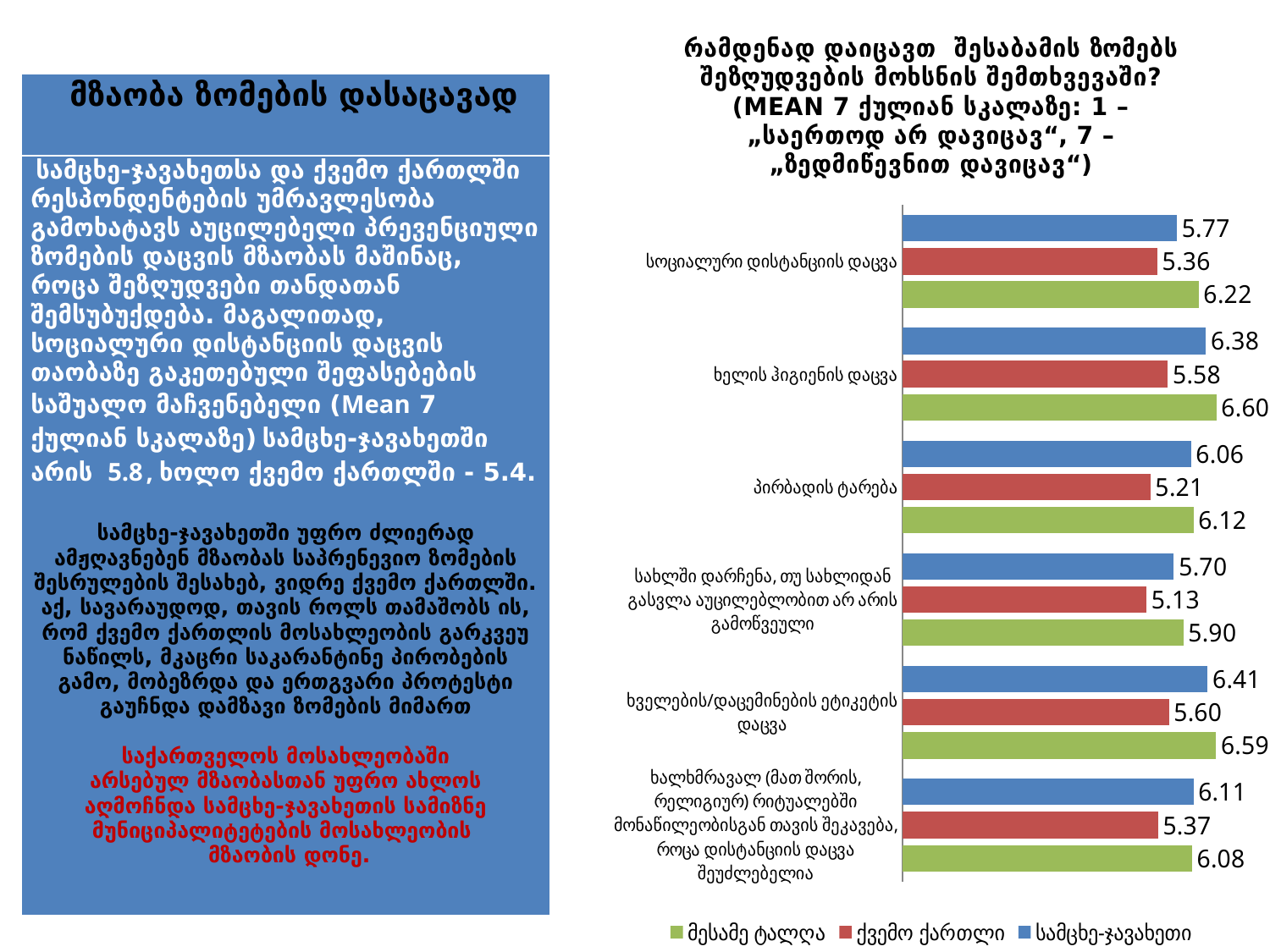
What type of chart is shown on the slide? bar chart What is the value for ქვემო ქართლი in the category პირბადის ტარება? 5.21 How many series does the chart legend list? 3 What is the difference between the მესამე ტალღა and ქვემო ქართლი values in the category ხელის ჰიგიენის დაცვა? 1.02 What is the difference between the სამცხე-ჯავახეთი and ქვემო ქართლი values in the category სოციალური დისტანციის დაცვა? 0.41 Which category has the lowest value for სამცხე-ჯავახეთი? სახლში დარჩენა, თუ სახლიდან გასვლა აუცილებლობით არ არის გამოწვეული What is the value for სამცხე-ჯავახეთი in the category სოციალური დისტანციის დაცვა? 5.77 Which category has the highest value for ქვემო ქართლი? ხველების/დაცემინების ეტიკეტის დაცვა Which colour represents the series ქვემო ქართლი in the chart? red What is the value for მესამე ტალღა in the category ხელის ჰიგიენის დაცვა? 6.60 In the category ხველების/დაცემინების ეტიკეტის დაცვა, which is larger: the value for სამცხე-ჯავახეთი or for ქვემო ქართლი? სამცხე-ჯავახეთი How many categories are shown on the chart? 6